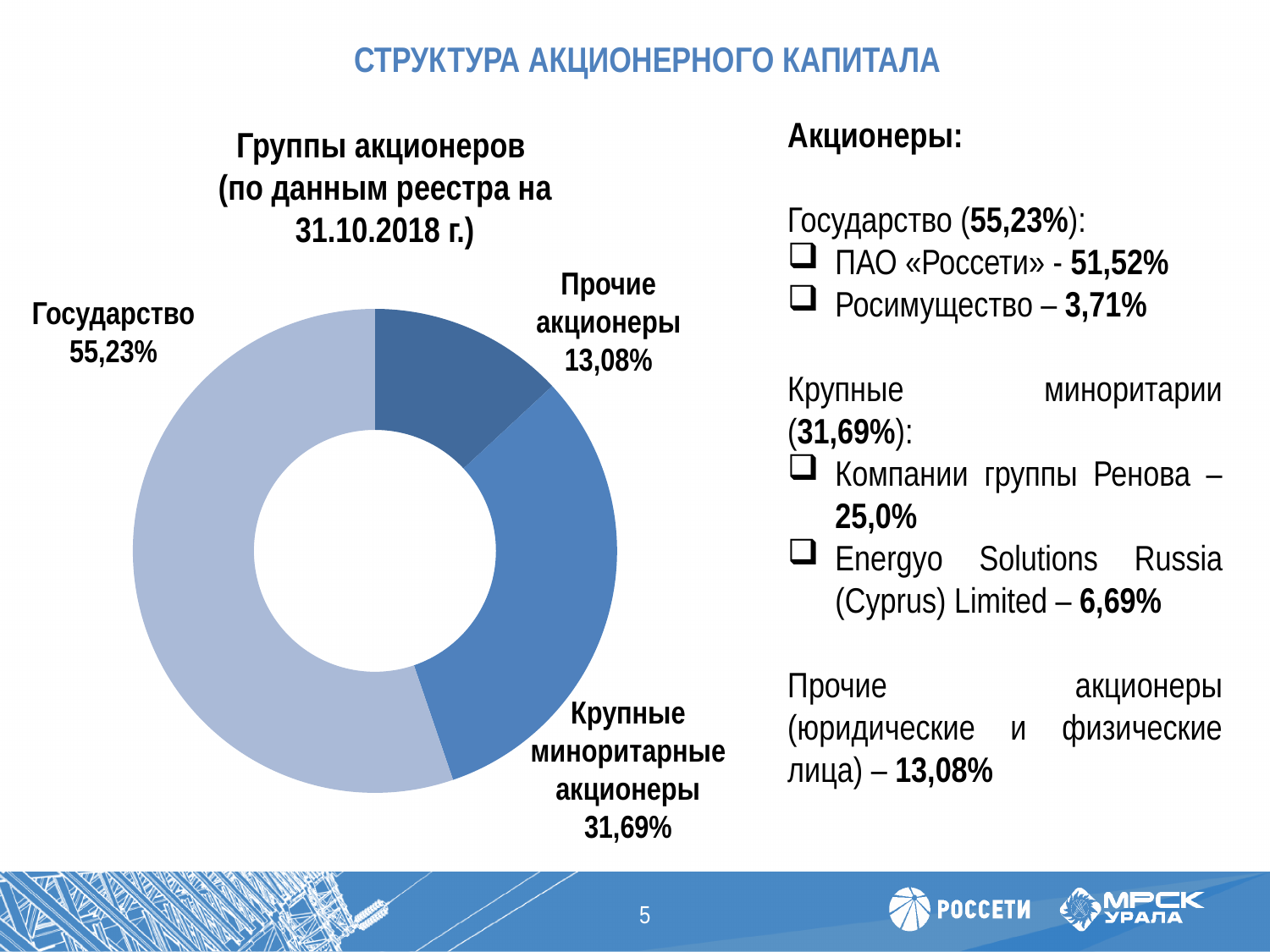
Which shareholder group has the smallest share in the chart? Прочие акционеры What is the title of the chart? Группы акционеров (по данным реестра на 31.10.2018 г.) Is the share of Государство greater or less than 50%? greater What is the difference in percentage points between Крупные миноритарные акционеры and Прочие акционеры? 18,61 Which shareholder group has the largest share in the chart? Государство What is the value shown for Прочие акционеры in the chart? 13,08% What is the difference in percentage points between Государство and Крупные миноритарные акционеры? 23,54 What type of chart is used to show the shareholder groups? Donut (pie) chart How many shareholder groups are shown in the chart? 3 What is the value shown for Крупные миноритарные акционеры in the chart? 31,69% What share of the donut chart does Государство hold? 55,23% Which is larger: the share of Крупные миноритарные акционеры or the share of Прочие акционеры? Крупные миноритарные акционеры